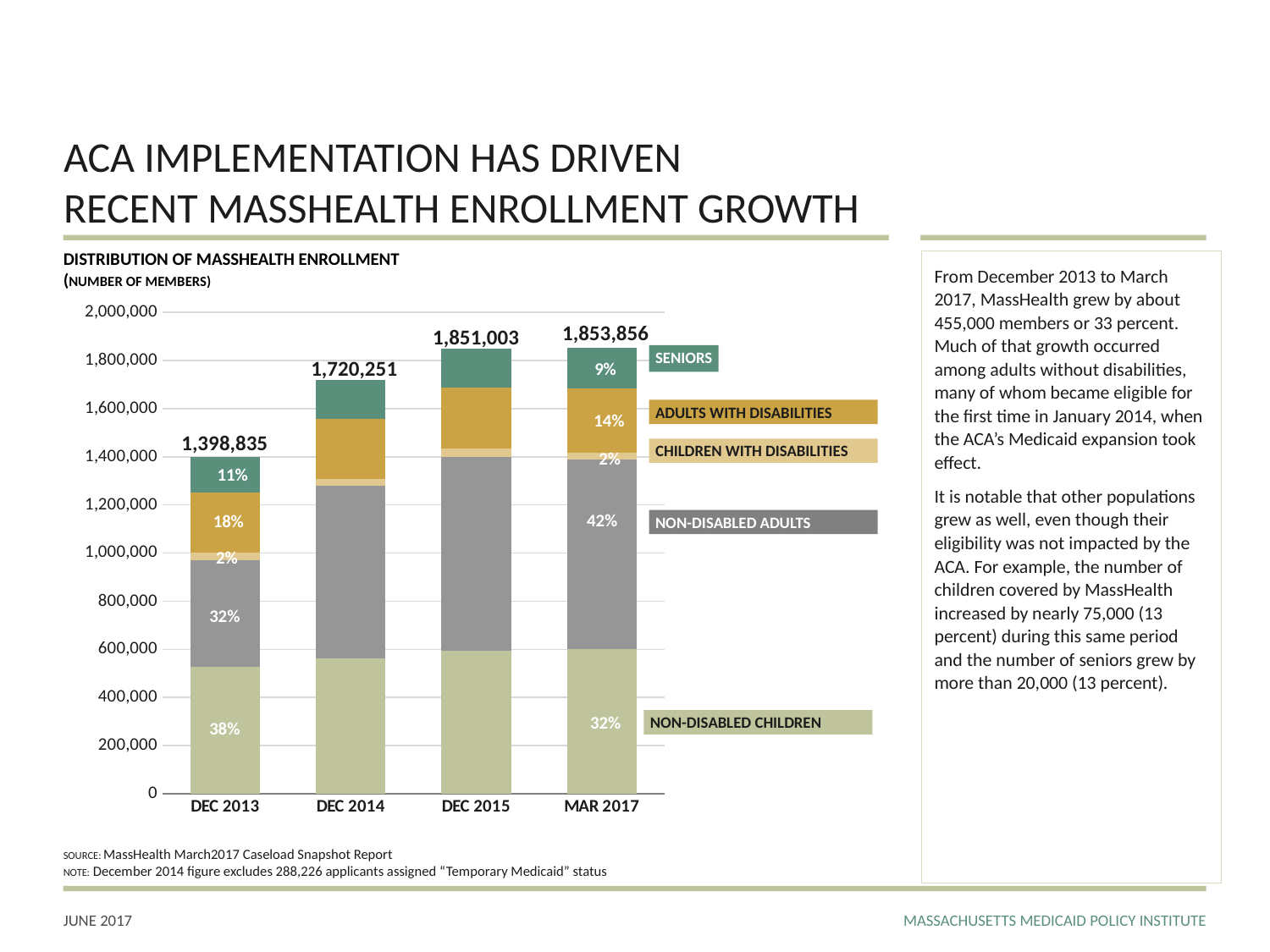
Was the share of non-disabled children larger in December 2013 or March 2017? DEC 2013 Which period shows the lowest total enrollment? DEC 2013 How many enrollment categories does the legend list? 5 What was the total MassHealth enrollment in December 2014? 1,720,251 What was the total MassHealth enrollment in March 2017? 1,853,856 What percentage of enrollment in December 2013 was seniors? 11% Which period shows the highest total enrollment? MAR 2017 What percentage of enrollment in March 2017 was non-disabled adults? 42% Does total enrollment rise or fall from December 2013 to March 2017? Rise By how many members did total enrollment grow from December 2013 to December 2014? 321,416 How many time periods are shown on the x axis? 4 What was the total MassHealth enrollment in December 2013? 1,398,835